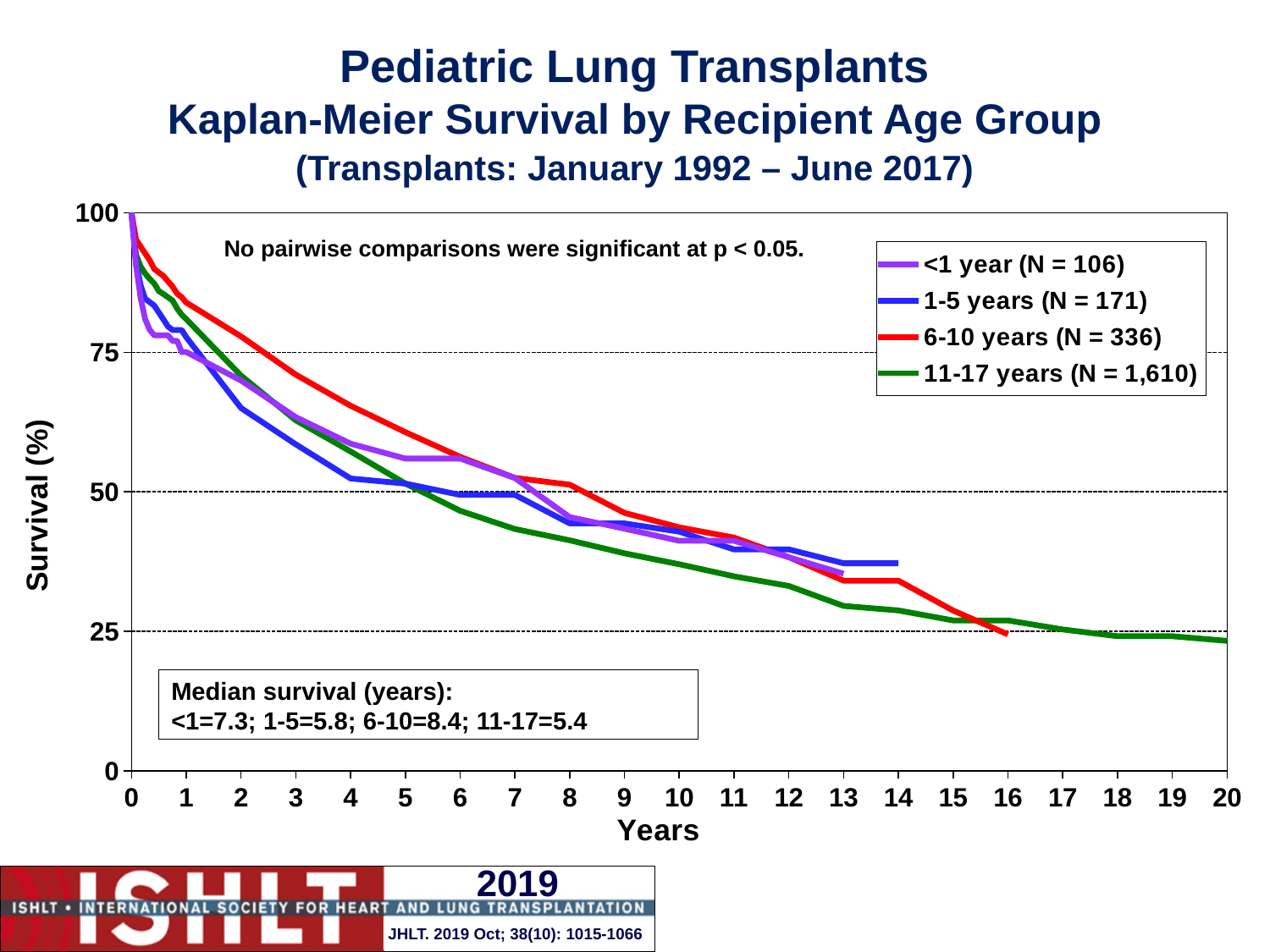
Which recipient age group has the highest median survival? 6-10 years Which series extends furthest along the x axis, reaching 20 years? 11-17 years Is the survival for the 11-17 years group at 10 years greater or less than 50%? less Which recipient age group has the lowest median survival? 11-17 years What is the median survival in years for the 11-17 years age group? 5.4 How many series does the legend list? 4 Which age group has the largest number of transplants (N) in the legend? 11-17 years (N = 1,610) What is the difference in median survival (years) between the 6-10 years group and the 11-17 years group? 3.0 What is the median survival in years for the 6-10 years age group? 8.4 What kind of chart is shown on the slide? line chart Do the survival curves rise or fall as years increase? fall Is the survival for the 6-10 years group at 1 year greater or less than 75%? greater